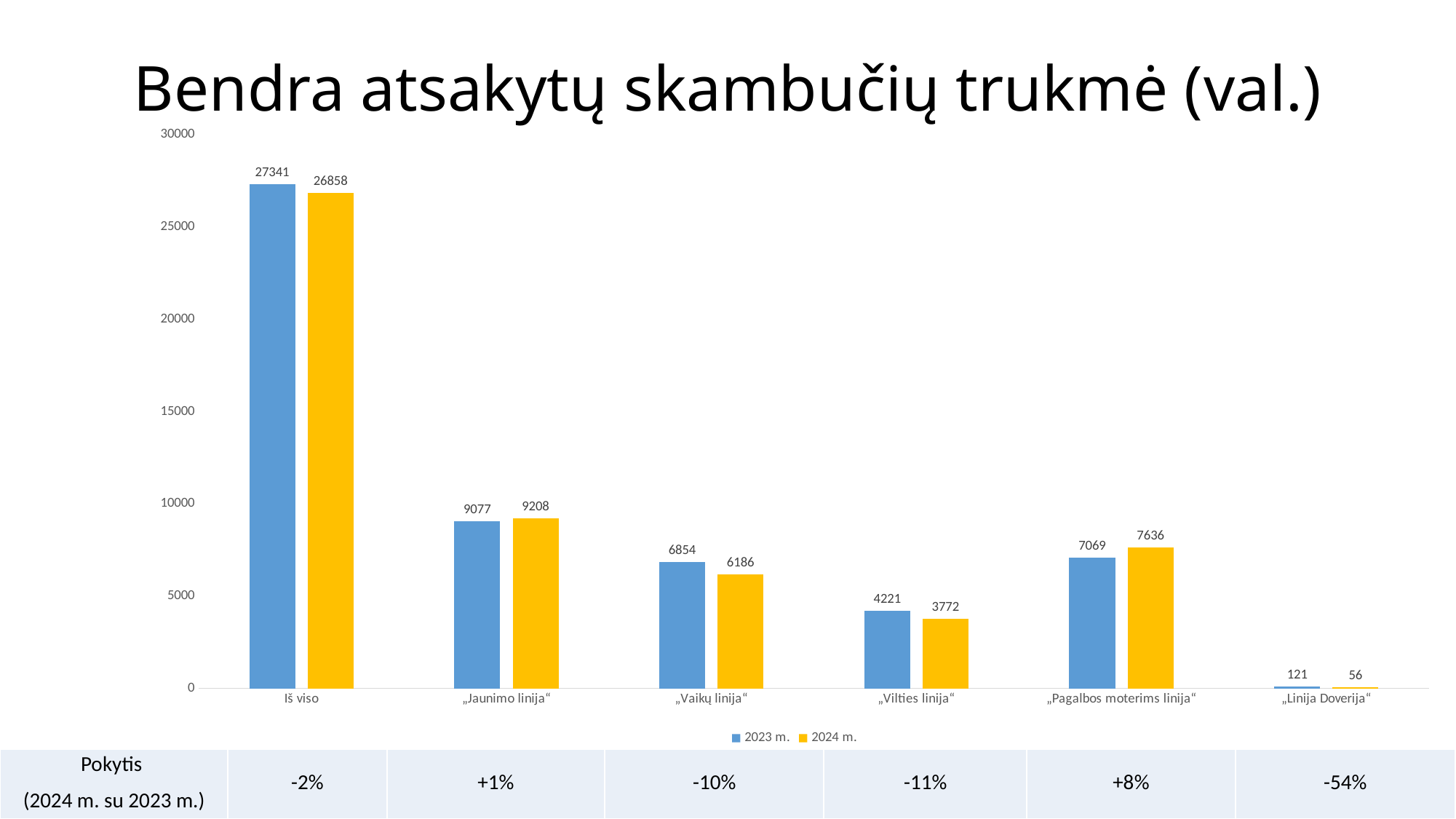
What is the value for „Jaunimo linija“ in the 2024 m. series? 9208 Is the 2023 m. value for „Vaikų linija“ greater or less than 5000? greater What kind of chart is shown on the slide? bar chart How many series does the legend list? 2 What is the value for „Linija Doverija“ in the 2024 m. series? 56 What is the value for „Vilties linija“ in the 2023 m. series? 4221 Excluding Iš viso, which category has the highest value in the 2024 m. series? „Jaunimo linija“ Which category has the lowest value in the 2023 m. series? „Linija Doverija“ How many categories are shown on the x axis? 6 What is the difference between the 2024 m. and 2023 m. values for „Pagalbos moterims linija“? 567 What is the difference between the 2023 m. and 2024 m. values for „Vaikų linija“? 668 Which is larger for „Vilties linija“: the 2023 m. value or the 2024 m. value? 2023 m.